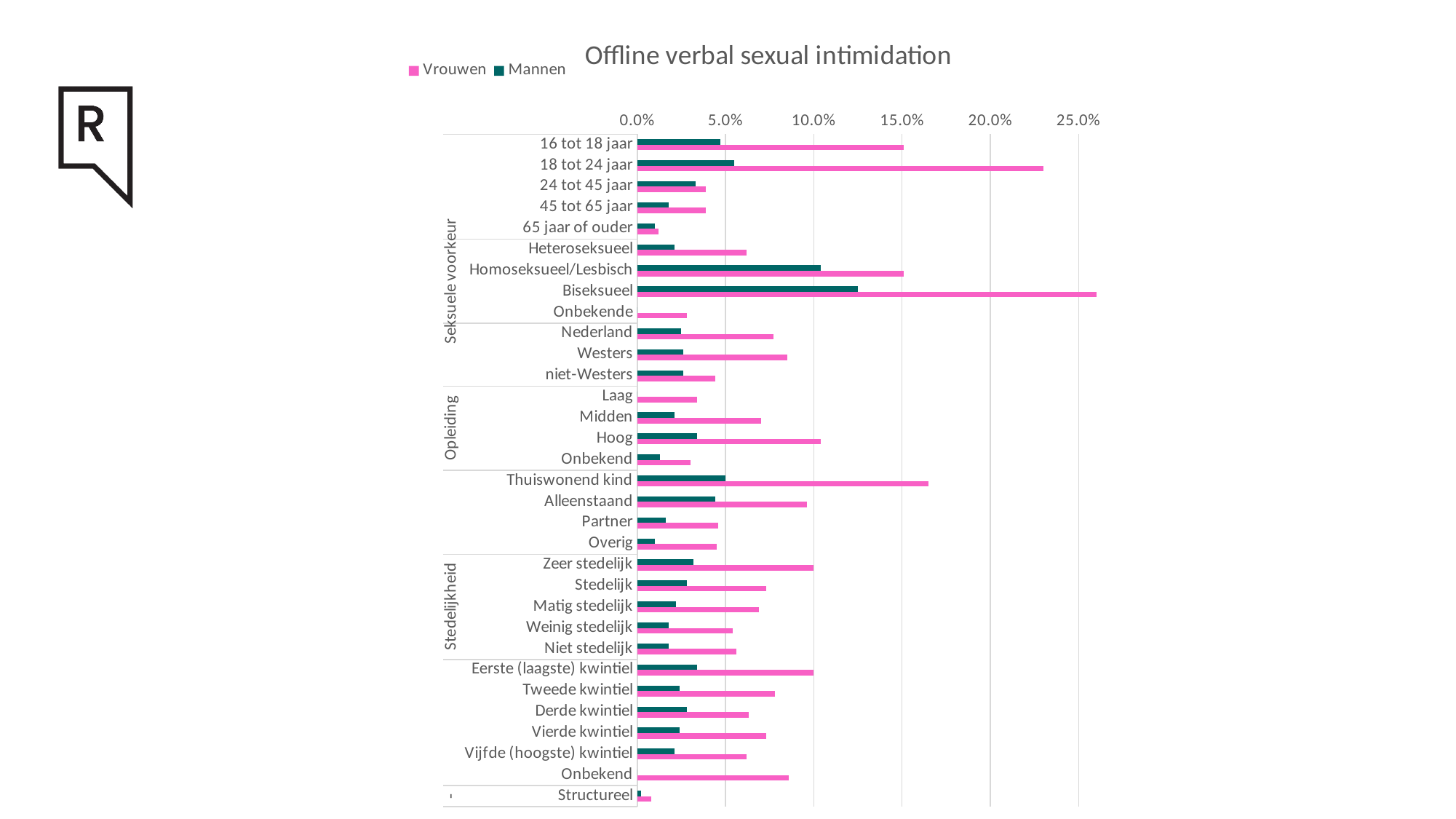
What type of chart is shown on the slide? bar chart Which category has the highest Mannen value? Biseksueel Which is larger for Vrouwen: Thuiswonend kind or Alleenstaand? Thuiswonend kind Is the Mannen value for Biseksueel greater or less than 10%? greater Is the Vrouwen value for Heteroseksueel greater or less than 10%? less Which series is shown in pink? Vrouwen Which is larger for Vrouwen: 18 tot 24 jaar or 16 tot 18 jaar? 18 tot 24 jaar How many categories are plotted on the vertical axis? 32 Which category has the highest Vrouwen value? Biseksueel Is the Vrouwen value for 18 tot 24 jaar greater or less than 20%? greater How many series does the legend list? 2 What is the title of the chart? Offline verbal sexual intimidation